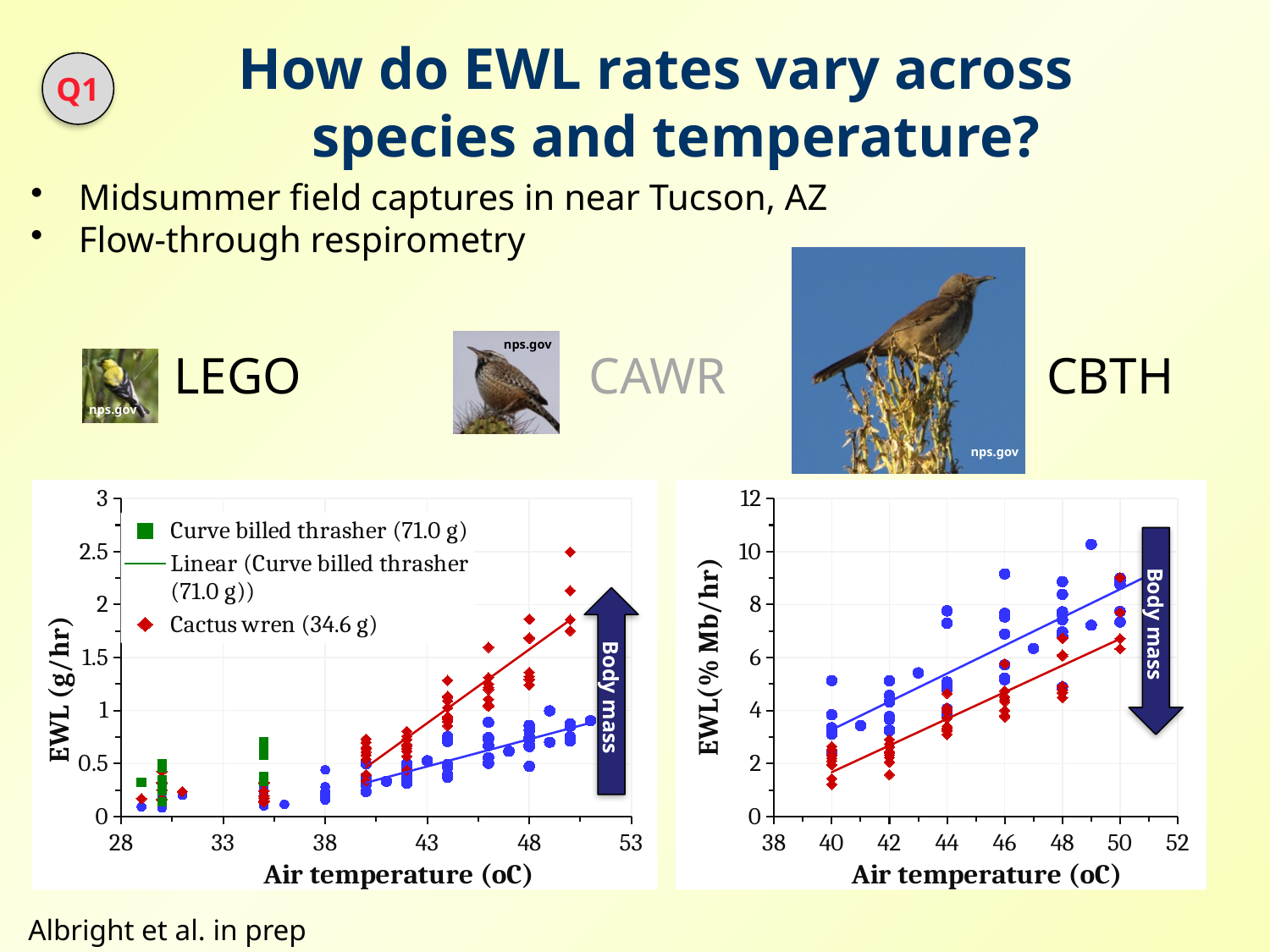
In the left chart, do the Cactus wren EWL values rise or fall as air temperature increases? rise In the left chart, what body mass is given for the Curve billed thrasher in the legend? 71.0 g In the left chart, at 48 °C, are the red (Cactus wren) points higher or lower than the blue points? higher In the right chart, at 44 °C, are the blue points higher or lower than the red points? higher What kind of chart is the left chart (EWL in g/hr)? scatter plot In the right chart, do the EWL values rise or fall as air temperature increases? rise What kind of chart is the right chart (EWL in % Mb/hr)? scatter plot In the right chart, is the highest blue point greater or less than 8 % Mb/hr? greater In the left chart, how many entries does the legend list? 3 In the left chart, what body mass is given for the Cactus wren in the legend? 34.6 g In the left chart, is the highest Cactus wren EWL value greater or less than 2 g/hr? greater What is the maximum value shown on the y-axis of the right chart? 12